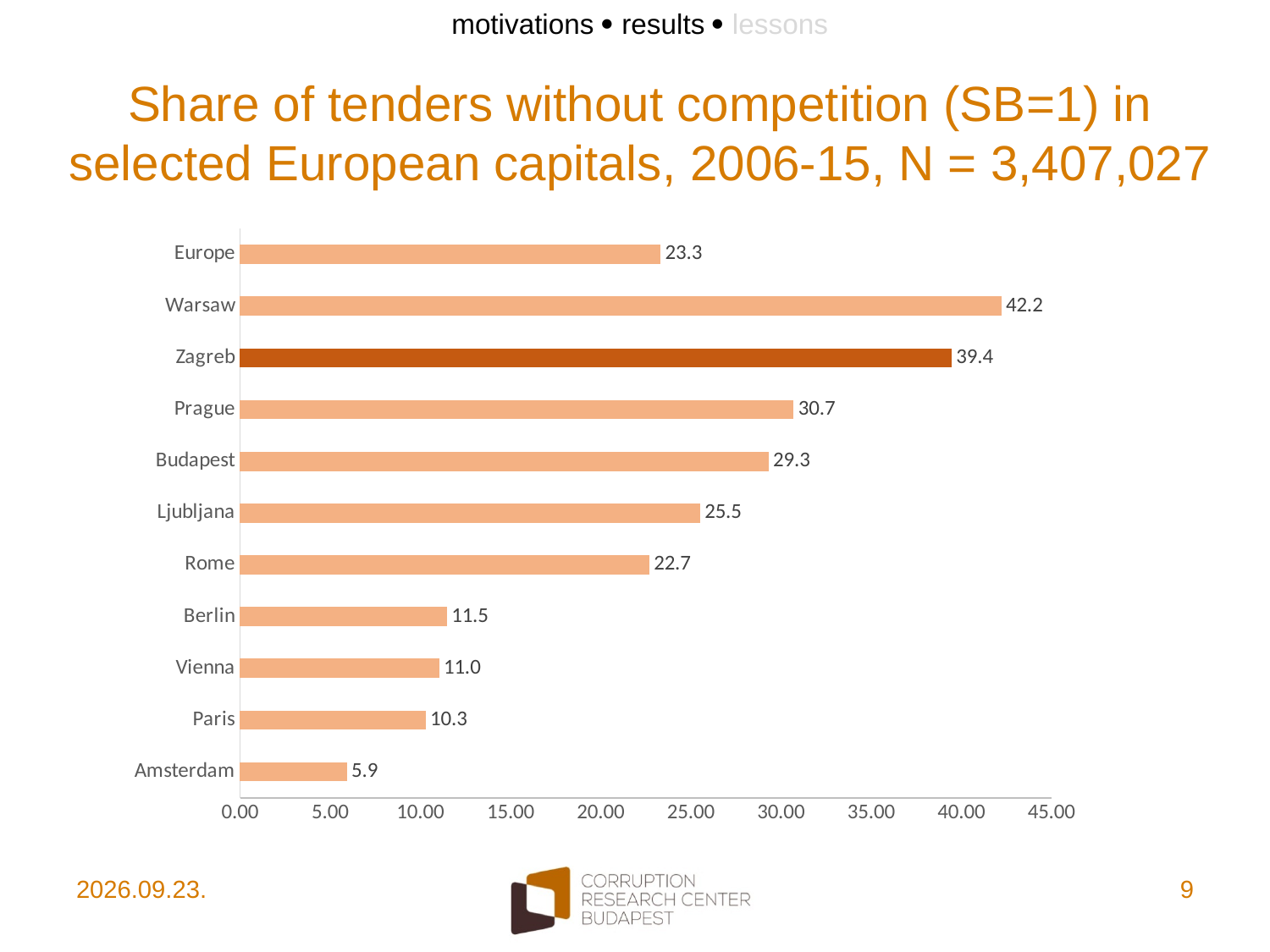
Which category's bar is drawn in a darker colour than the others? Zagreb What is the difference between the values for Prague and Paris? 20.4 Which category has the lowest value? Amsterdam What kind of chart is shown on the slide? bar chart What is the value for Europe? 23.3 Is the value for Zagreb greater or less than 35.00? greater What is the difference between the values for Warsaw and Zagreb? 2.8 Which is larger, the value for Ljubljana or the value for Rome? Ljubljana What is the value for Budapest? 29.3 Which category has the highest value? Warsaw How many categories are shown on the chart? 11 What is the value for Warsaw? 42.2